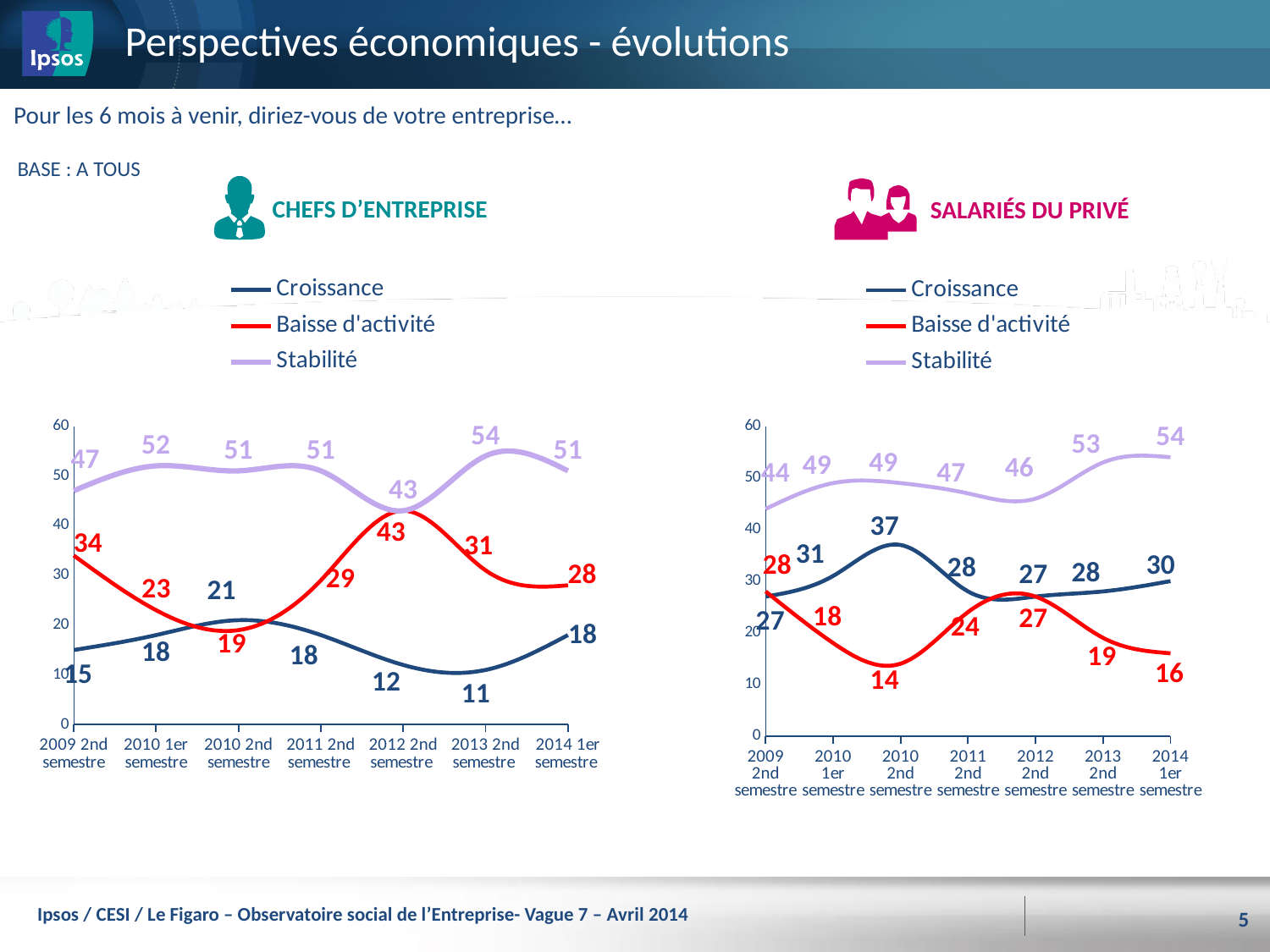
On the SALARIÉS DU PRIVÉ chart, which period has the lowest Baisse d'activité value? 2010 2nd semestre On the CHEFS D'ENTREPRISE chart, what is the value of Croissance for 2013 2nd semestre? 11 What kind of chart is the CHEFS D'ENTREPRISE chart? Line chart On the CHEFS D'ENTREPRISE chart, which period has the highest Stabilité value? 2013 2nd semestre On the SALARIÉS DU PRIVÉ chart, which is larger for 2013 2nd semestre: Croissance or Baisse d'activité? Croissance How many time periods are plotted on the SALARIÉS DU PRIVÉ chart? 7 On the SALARIÉS DU PRIVÉ chart, does Stabilité rise or fall from 2012 2nd semestre to 2014 1er semestre? Rise On the SALARIÉS DU PRIVÉ chart, what is the value of Croissance for 2010 2nd semestre? 37 On the SALARIÉS DU PRIVÉ chart, what is the value of Stabilité for 2014 1er semestre? 54 How many series does the legend of the CHEFS D'ENTREPRISE chart list? 3 On the CHEFS D'ENTREPRISE chart, what is the value of Baisse d'activité for 2012 2nd semestre? 43 On the CHEFS D'ENTREPRISE chart, what is the difference between Stabilité and Croissance for 2014 1er semestre? 33